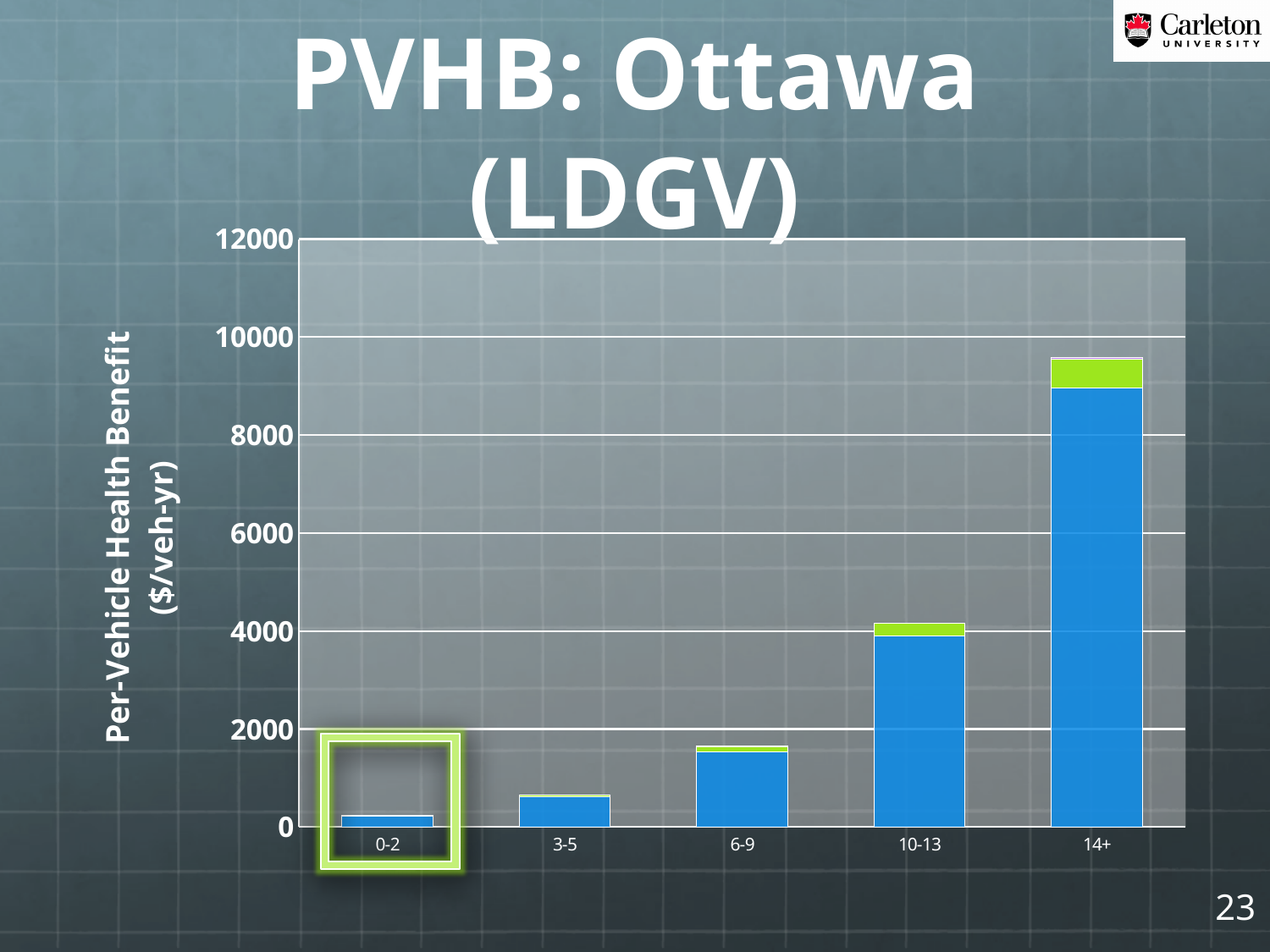
Is the total value for 3-5 greater or less than 1000? less Is the total value for 6-9 greater or less than 2000? less What kind of chart is shown on the slide? bar chart Which is larger, the total bar for 10-13 or the total bar for 6-9? 10-13 Which category has the lowest total bar in the chart? 0-2 How many categories are shown on the x axis of the chart? 5 Is the total value for 14+ greater or less than 8000? greater What is the title of the chart on the slide? PVHB: Ottawa (LDGV) What is the label of the vertical axis of the chart? Per-Vehicle Health Benefit ($/veh-yr) Which category has the highest total bar in the chart? 14+ Do the bar values rise or fall moving from left to right along the x axis? rise